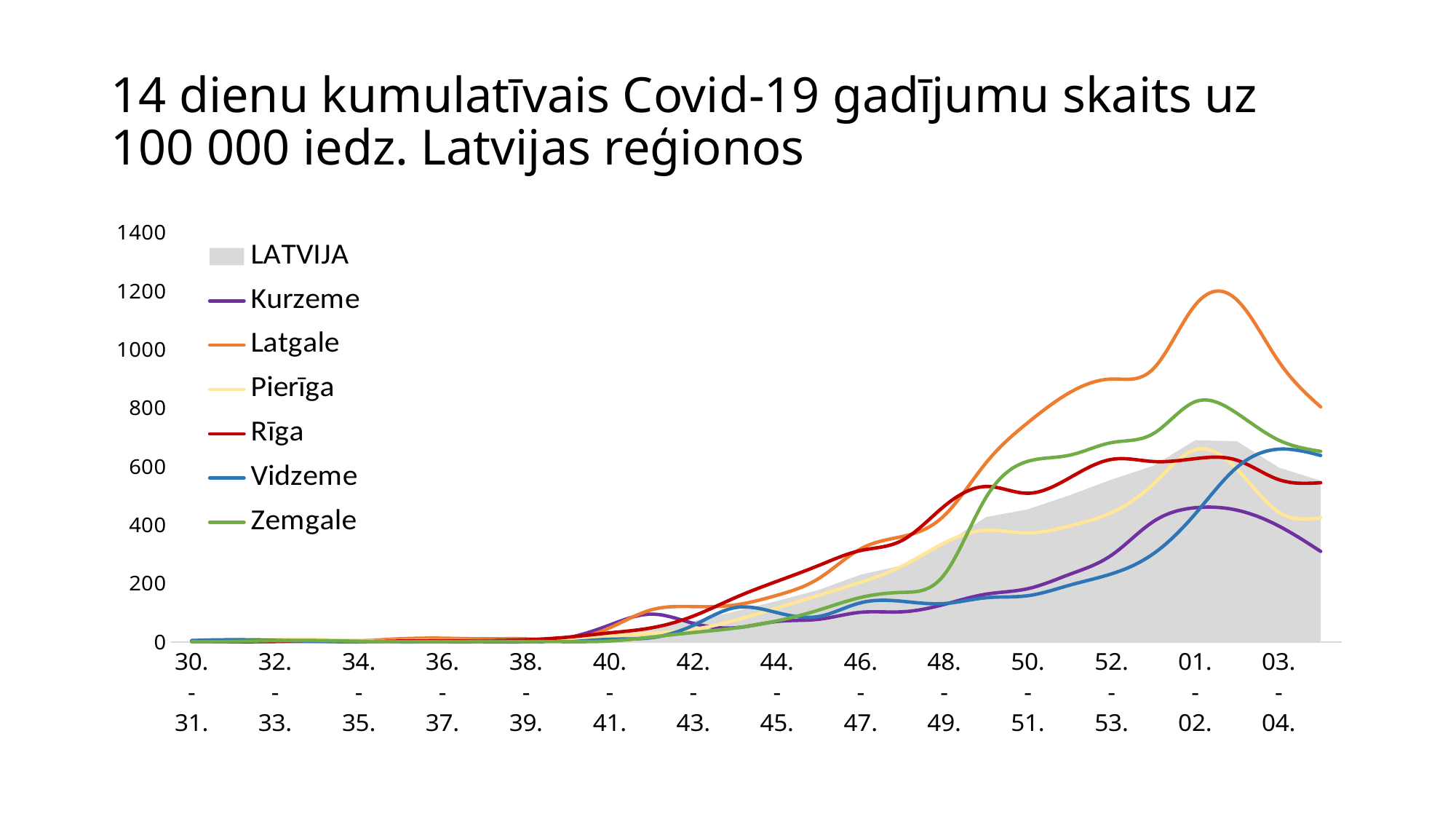
What is the title of the chart? 14 dienu kumulatīvais Covid-19 gadījumu skaits uz 100 000 iedz. Latvijas reģionos How many labelled points are there on the x axis? 14 Is the value for Pierīga at the last point (03.-04.) greater or less than 600? less Do the values generally rise or fall from 30.-31. to 01.-02.? rise What kind of chart is shown on the slide? line chart At the 01.-02. point, which is larger: Latgale or Kurzeme? Latgale Is the peak value for Kurzeme greater or less than 600? less Which region reaches the highest value on the chart? Latgale How many series does the legend list? 7 Is the value for Vidzeme at the last point (03.-04.) greater or less than 400? greater Which series is shown as a shaded grey area rather than a line? LATVIJA